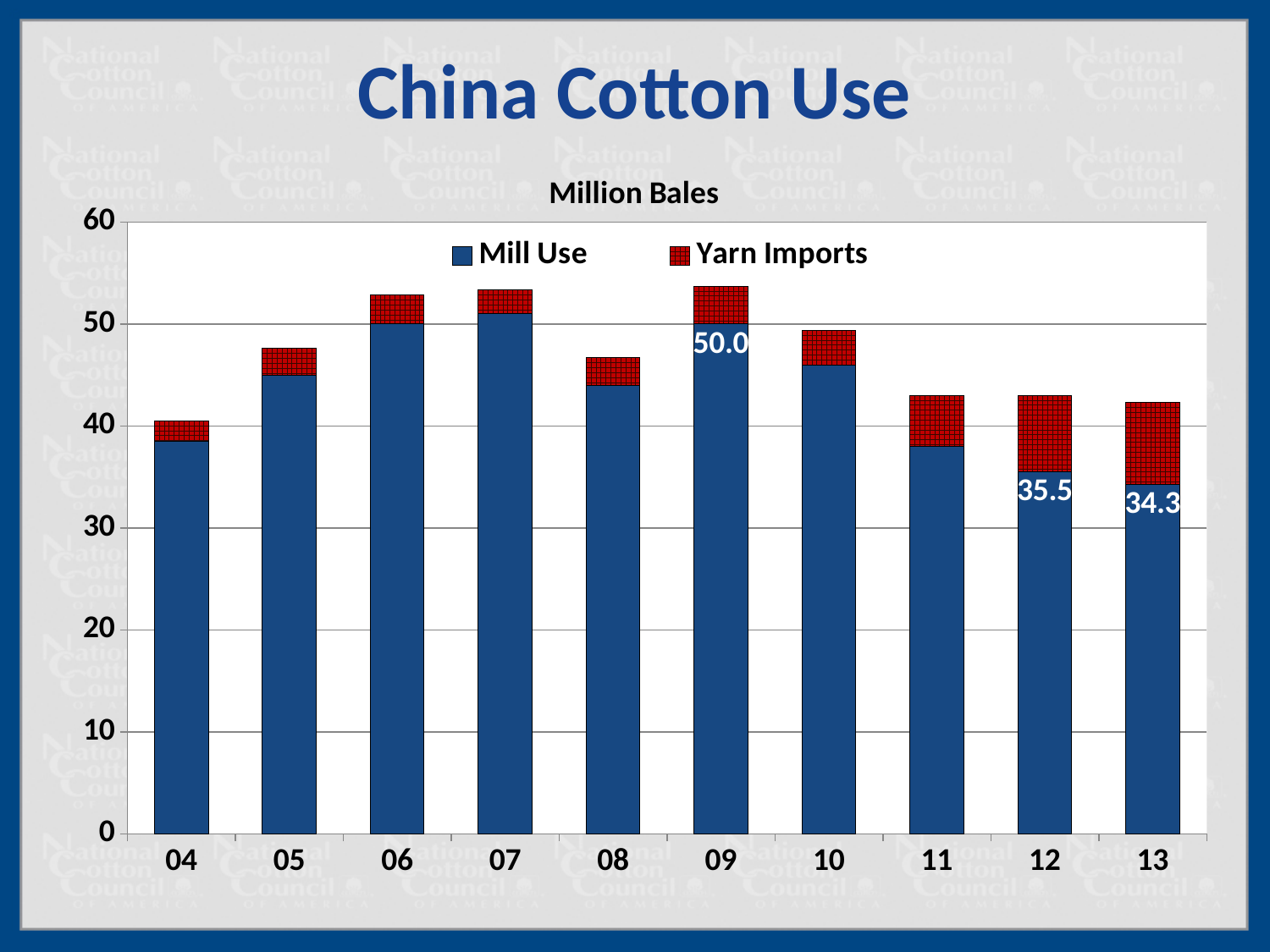
Which year has the lowest total stacked bar? 04 Is the total height of the stacked bar for 06 greater or less than 50? greater How many series does the legend list? 2 What is the Mill Use value for 12? 35.5 What is the difference between the Mill Use values for 09 and 12? 14.5 What is the difference between the Mill Use values for 12 and 13? 1.2 What is the Mill Use value for 09? 50.0 Which year has the larger Mill Use value, 12 or 13? 12 Is the Mill Use value for 04 greater or less than 40? less How many years are shown on the x axis? 10 What kind of chart is shown on the slide? Stacked bar chart What is the Mill Use value for 13? 34.3